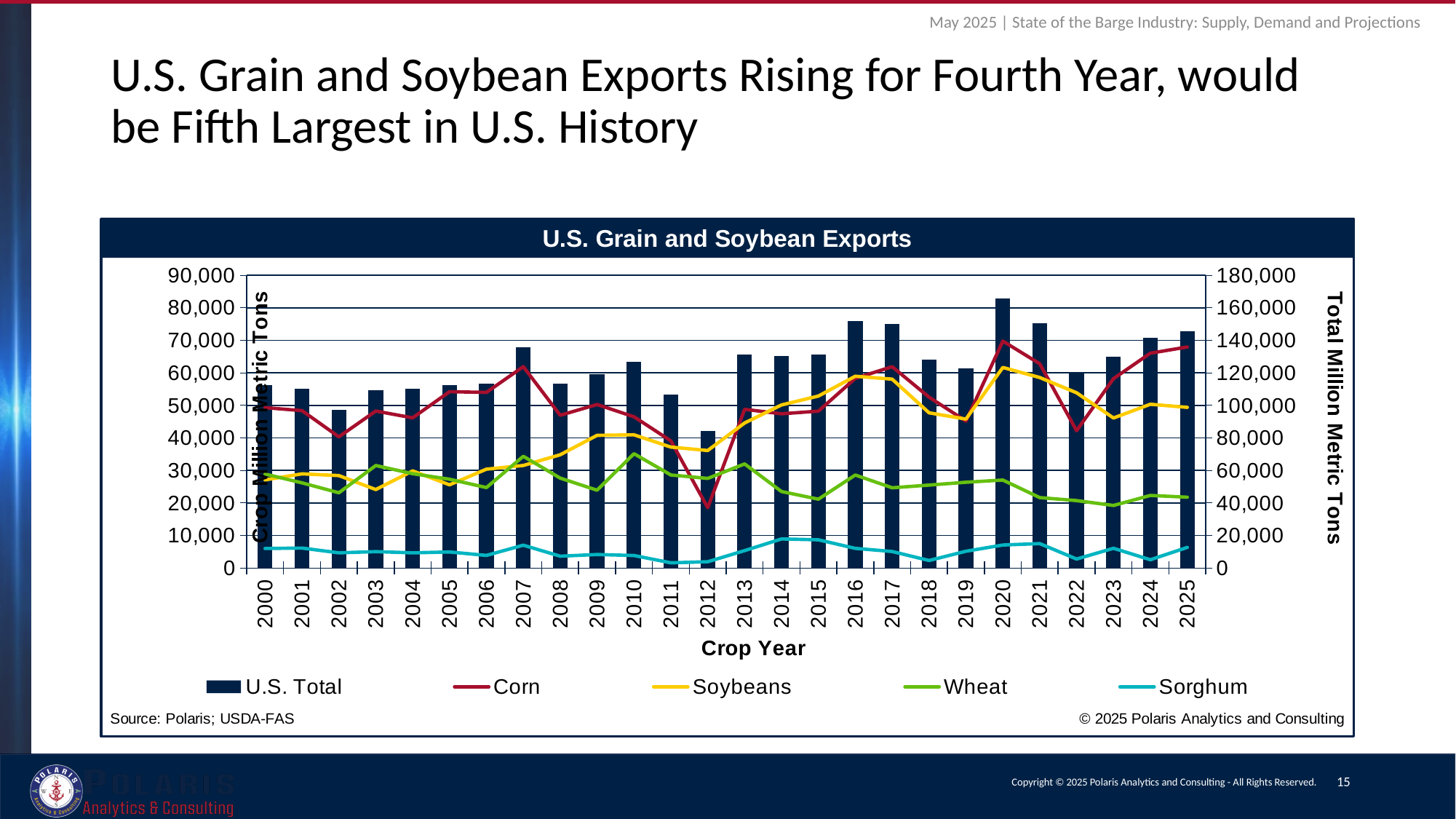
What kind of chart is shown on the slide? A combination bar and line chart In 2012, which is larger, the Corn value or the Soybeans value? Soybeans Does the U.S. Total rise or fall from 2022 to 2025? Rise In which crop year does the Corn line reach its lowest point? 2012 What is the title of the chart? U.S. Grain and Soybean Exports How many series does the legend list? 5 Is the U.S. Total value for 2012 greater or less than 100,000 on the right axis? less Is the U.S. Total value for 2020 greater or less than 140,000 on the right axis? greater How many crop years are shown on the x axis? 26 In which crop year is the U.S. Total bar the highest? 2020 In which crop year is the U.S. Total bar the lowest? 2012